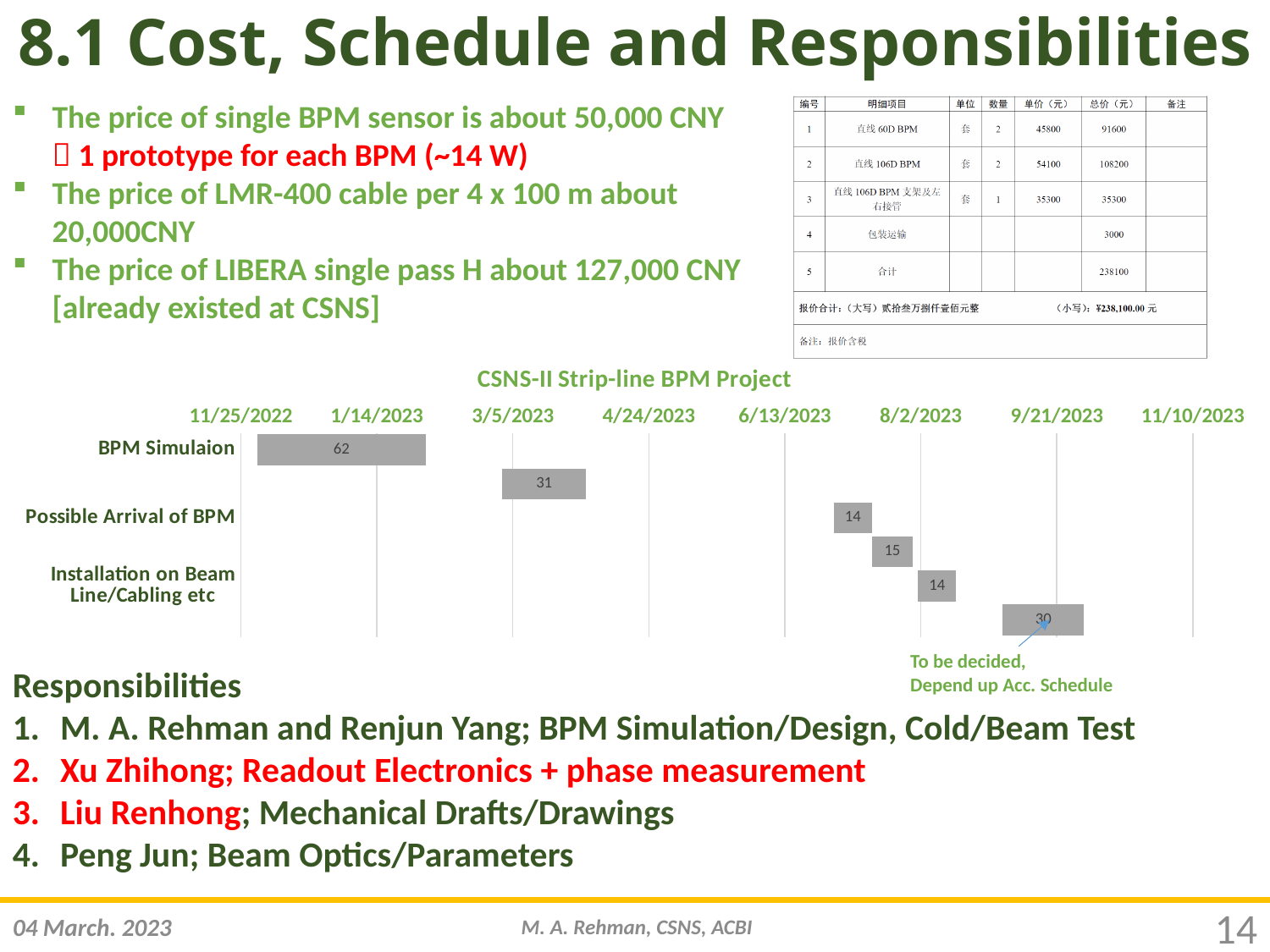
In the CSNS-II Strip-line BPM Project chart, which labelled task has the longest bar? BPM Simulaion In the CSNS-II Strip-line BPM Project chart, what value is labelled on the Possible Arrival of BPM bar? 14 What is the first date shown on the x axis of the CSNS-II Strip-line BPM Project chart? 11/25/2022 In the CSNS-II Strip-line BPM Project chart, which is larger: the BPM Simulaion bar or the Possible Arrival of BPM bar? BPM Simulaion What kind of chart is shown under the heading 'CSNS-II Strip-line BPM Project'? bar chart What is the smallest value label shown on any bar in the CSNS-II Strip-line BPM Project chart? 14 In the CSNS-II Strip-line BPM Project chart, what is the difference between the BPM Simulaion value and the Possible Arrival of BPM value? 48 What is the title of the chart in the middle of the slide? CSNS-II Strip-line BPM Project How many bars are plotted in the CSNS-II Strip-line BPM Project chart? 6 In the CSNS-II Strip-line BPM Project chart, what value is labelled on the rightmost (last) bar? 30 In the CSNS-II Strip-line BPM Project chart, what value is labelled on the Installation on Beam Line/Cabling etc bar? 14 In the CSNS-II Strip-line BPM Project chart, what value is labelled on the BPM Simulaion bar? 62